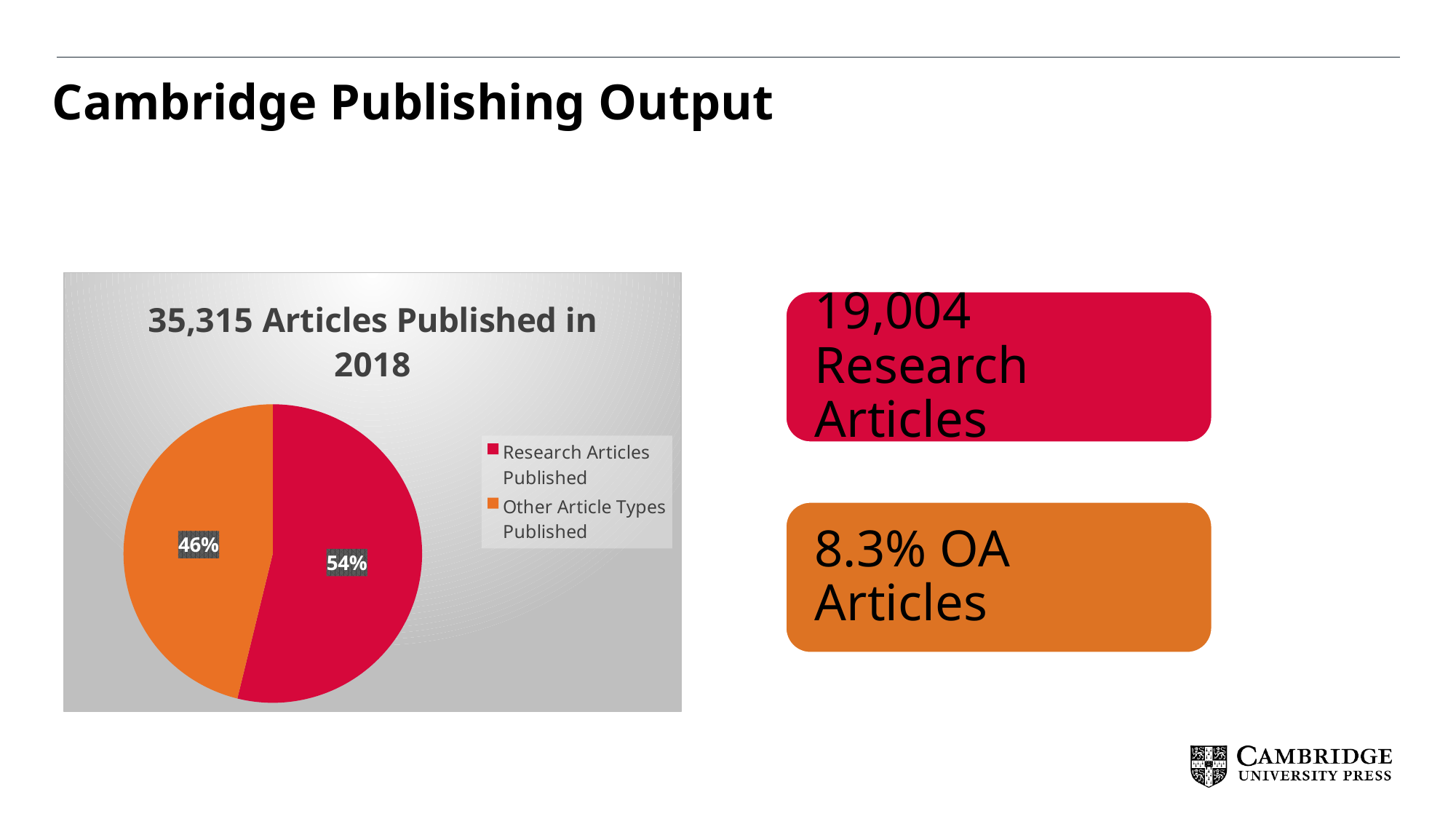
Which slice of the pie chart is the smallest? Other Article Types Published What share of the pie is Research Articles Published? 54% What is the difference in percentage points between the Research Articles Published slice and the Other Article Types Published slice? 8 How many entries does the legend of the pie chart list? 2 What colour is the Other Article Types Published slice in the pie chart? orange Which slice of the pie chart is the largest? Research Articles Published Which is larger: the share for Research Articles Published or the share for Other Article Types Published? Research Articles Published How many slices does the pie chart have? 2 What is the title of the pie chart? 35,315 Articles Published in 2018 What share of the pie is Other Article Types Published? 46% What type of chart is shown on the slide? pie chart